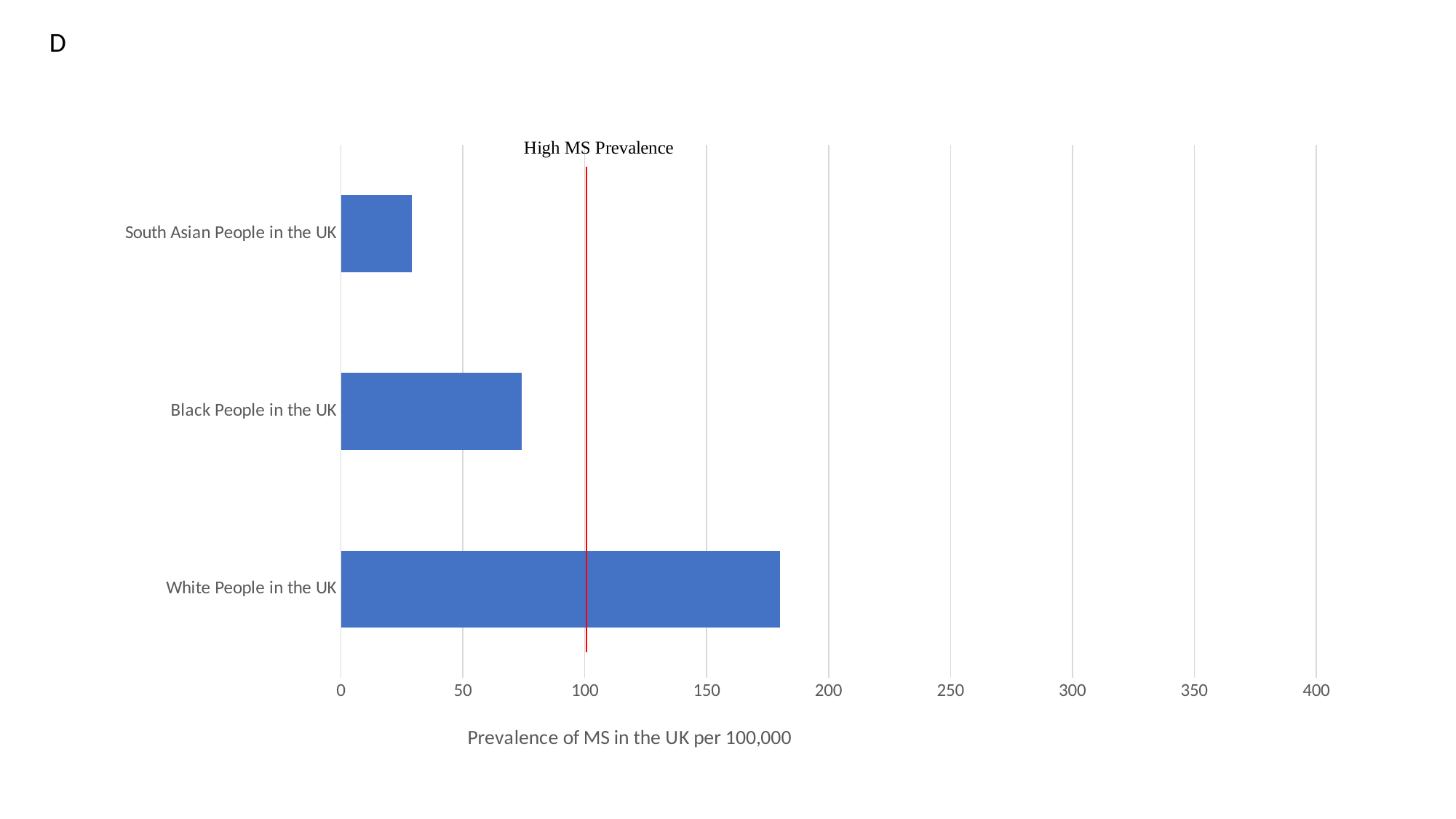
Is the value for White People in the UK greater or less than 200? less Which is larger, the value for White People in the UK or the value for Black People in the UK? White People in the UK Is the value for South Asian People in the UK greater or less than 50? less What kind of chart is shown on the slide? bar chart What is the title of the horizontal axis? Prevalence of MS in the UK per 100,000 Which category has the lowest prevalence of MS in the UK per 100,000? South Asian People in the UK Which category has the highest prevalence of MS in the UK per 100,000? White People in the UK Which is larger, the value for Black People in the UK or the value for South Asian People in the UK? Black People in the UK What does the red vertical line at 100 on the chart represent? High MS Prevalence Is the value for White People in the UK greater or less than 150? greater How many categories are plotted in the chart? 3